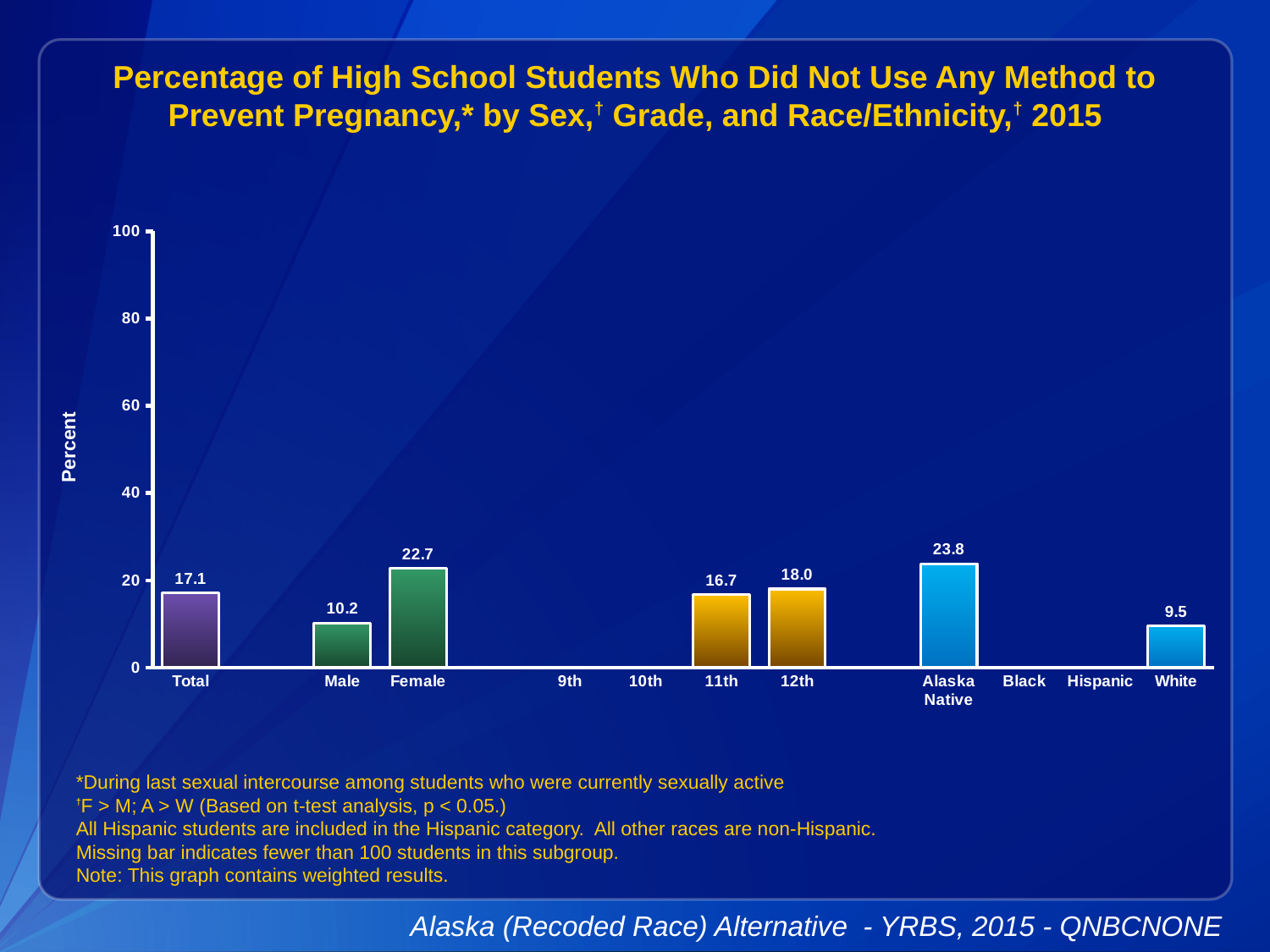
Which category with a plotted bar has the lowest value? White Is the value for Alaska Native greater or less than 20? greater How many categories have a plotted bar? 7 What is the value for Alaska Native? 23.8 Which is larger, the value for 11th or the value for 12th? 12th What kind of chart is shown? Bar chart What is the value for Total? 17.1 What is the value for Female? 22.7 What is the difference between the Female and Male values? 12.5 What is the label on the y axis? Percent Which category has the highest value? Alaska Native What is the value for White? 9.5